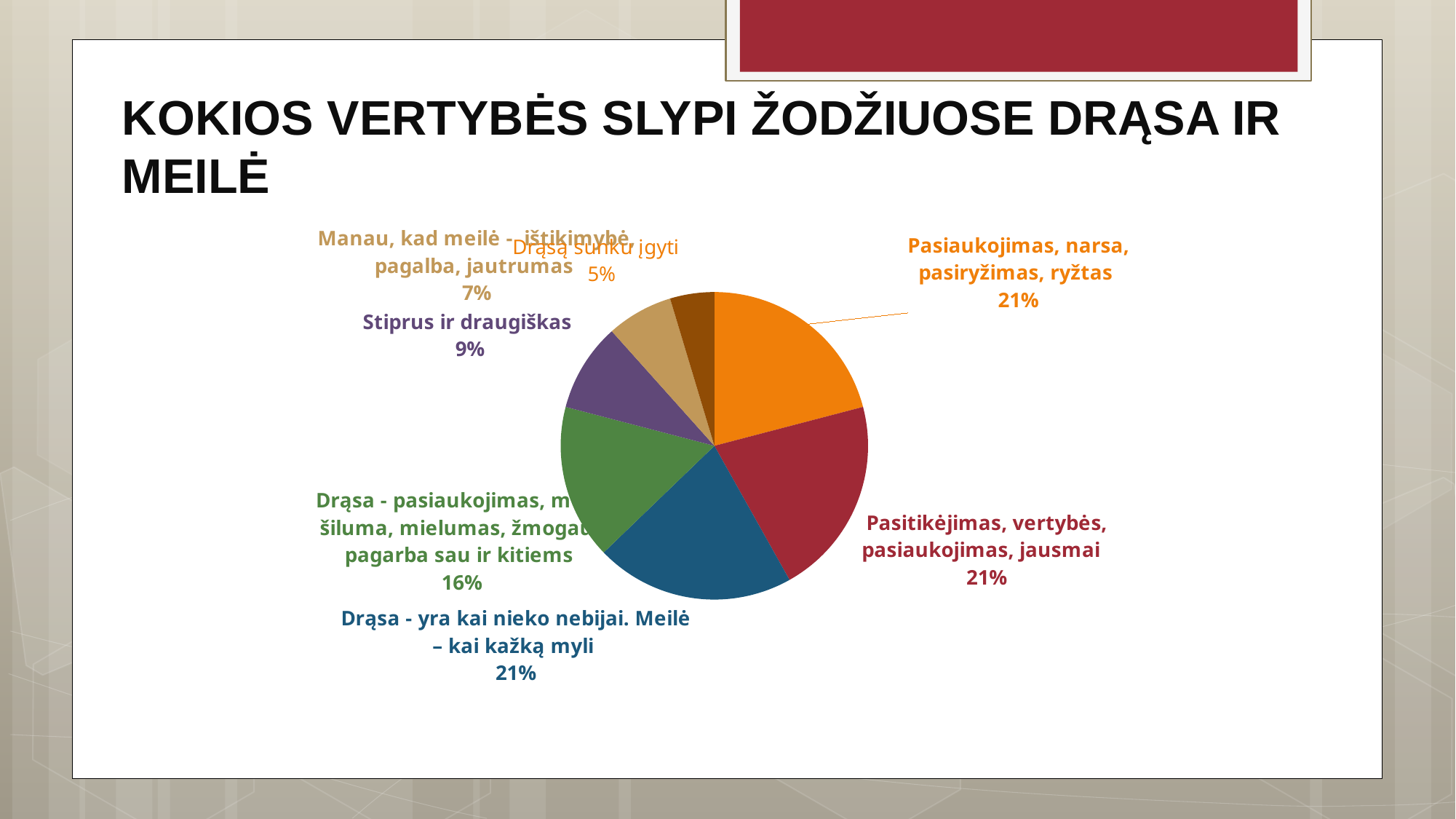
Which is larger: the share for "Stiprus ir draugiškas" or the share for "Drąsą sunku įgyti"? Stiprus ir draugiškas What kind of chart is shown on the slide? Pie chart Which slice of the pie is the smallest? Drąsą sunku įgyti What is the difference in percentage points between "Pasiaukojimas, narsa, pasiryžimas, ryžtas" and "Manau, kad meilė - ištikimybė, pagalba, jautrumas"? 14 What share of the pie does "Stiprus ir draugiškas" have? 9% What percentage is shown for "Pasitikėjimas, vertybės, pasiaukojimas, jausmai"? 21% What percentage is shown for "Drąsą sunku įgyti"? 5% What share is labelled for "Manau, kad meilė - ištikimybė, pagalba, jautrumas"? 7% What is the difference in percentage points between "Stiprus ir draugiškas" and "Drąsą sunku įgyti"? 4 How many slices does the pie chart have? 7 What percentage is shown for "Pasiaukojimas, narsa, pasiryžimas, ryžtas"? 21% What is the title of the slide containing the pie chart? KOKIOS VERTYBĖS SLYPI ŽODŽIUOSE DRĄSA IR MEILĖ